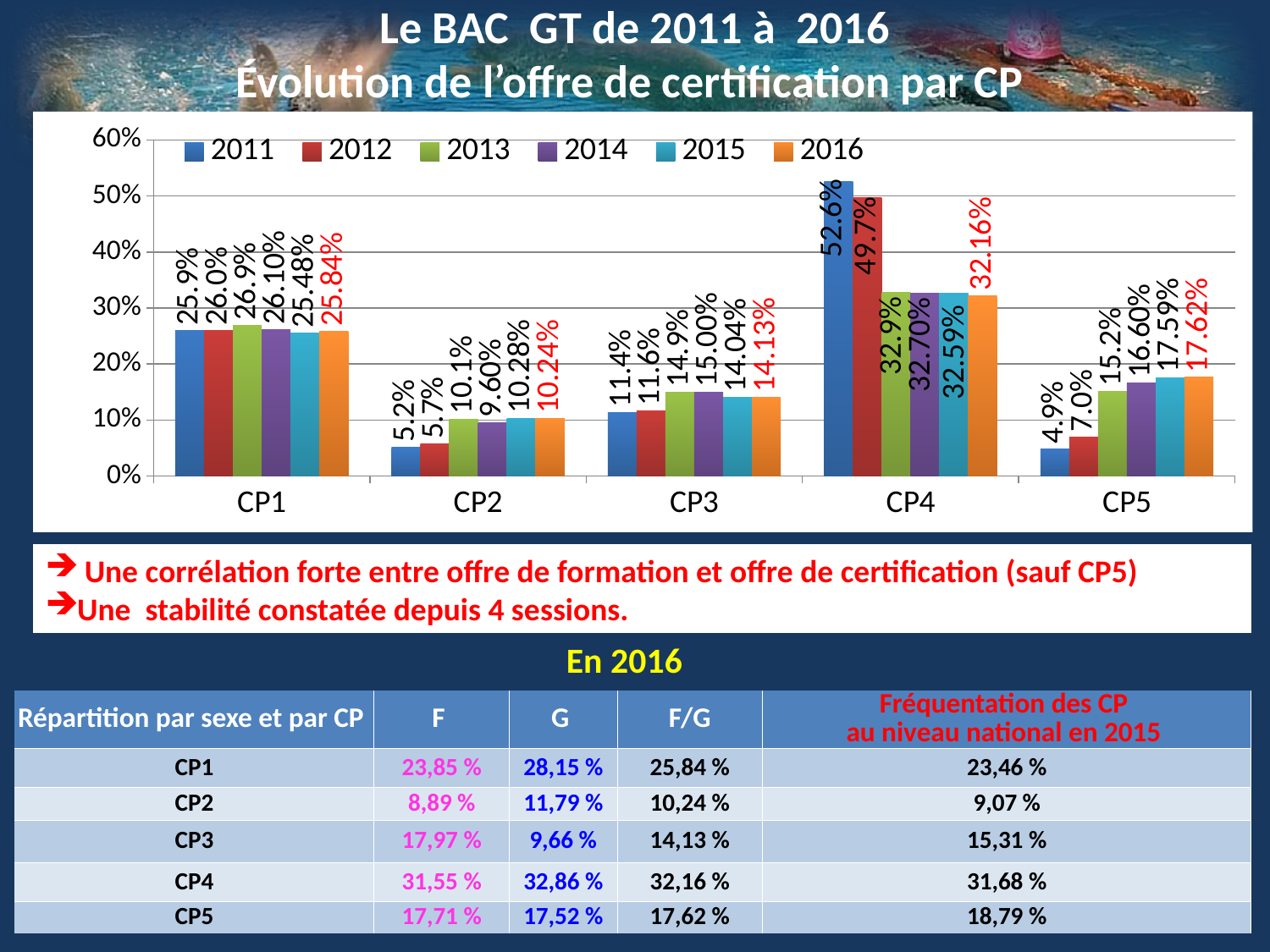
How many categories (CP groups) are shown on the x axis? 5 What is the difference between the 2016 and 2011 values for CP5? 12.72 percentage points What is the value for CP4 in 2011? 52.6% What is the difference between the 2011 and 2012 values for CP4? 2.9 percentage points Which category has the highest value in 2011? CP4 Is the value for CP3 in 2016 greater or less than 20%? less What is the value for CP5 in 2013? 15.2% How many series does the legend list? 6 Which is larger for CP3: the 2013 value or the 2011 value? 2013 Which category has the lowest value in 2011? CP5 What is the value for CP2 in 2016? 10.24% Do the values for CP5 rise or fall from 2011 to 2016? rise